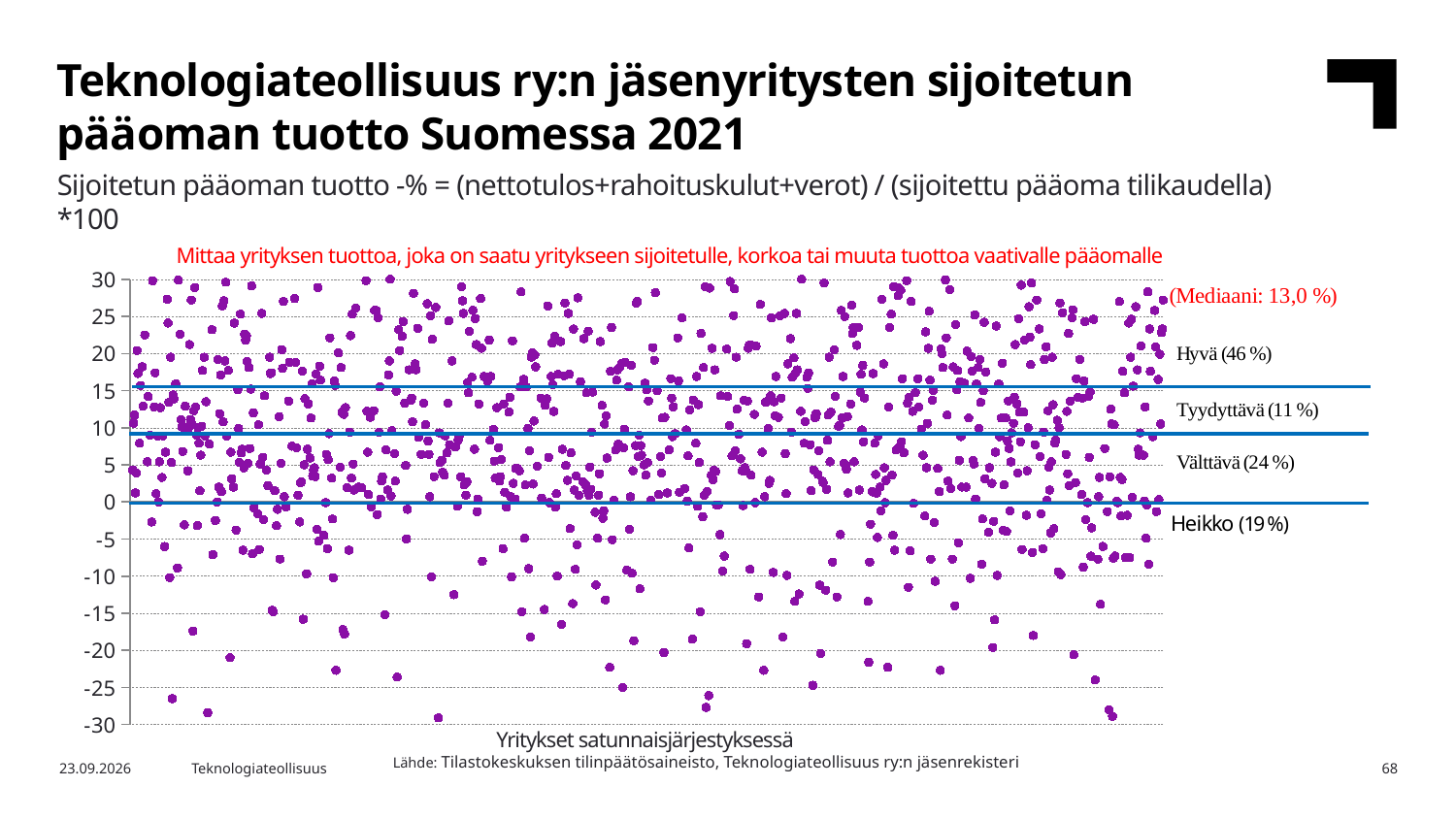
Which category (Hyvä, Tyydyttävä, Välttävä, Heikko) has the largest share of companies? Hyvä How many rating categories are labelled on the right side of the chart? 4 What share of companies falls into the Hyvä category? 46 % What is the label of the x axis? Yritykset satunnaisjärjestyksessä Which category (Hyvä, Tyydyttävä, Välttävä, Heikko) has the smallest share of companies? Tyydyttävä Which has a larger share of companies, Välttävä or Heikko? Välttävä What share of companies falls into the Heikko category? 19 % What is the median (Mediaani) value shown on the chart? 13,0 % What kind of chart is shown on the slide? scatter plot What is the difference in percentage points between the Hyvä share and the Heikko share? 27 What share of companies falls into the Välttävä category? 24 % What share of companies falls into the Tyydyttävä category? 11 %